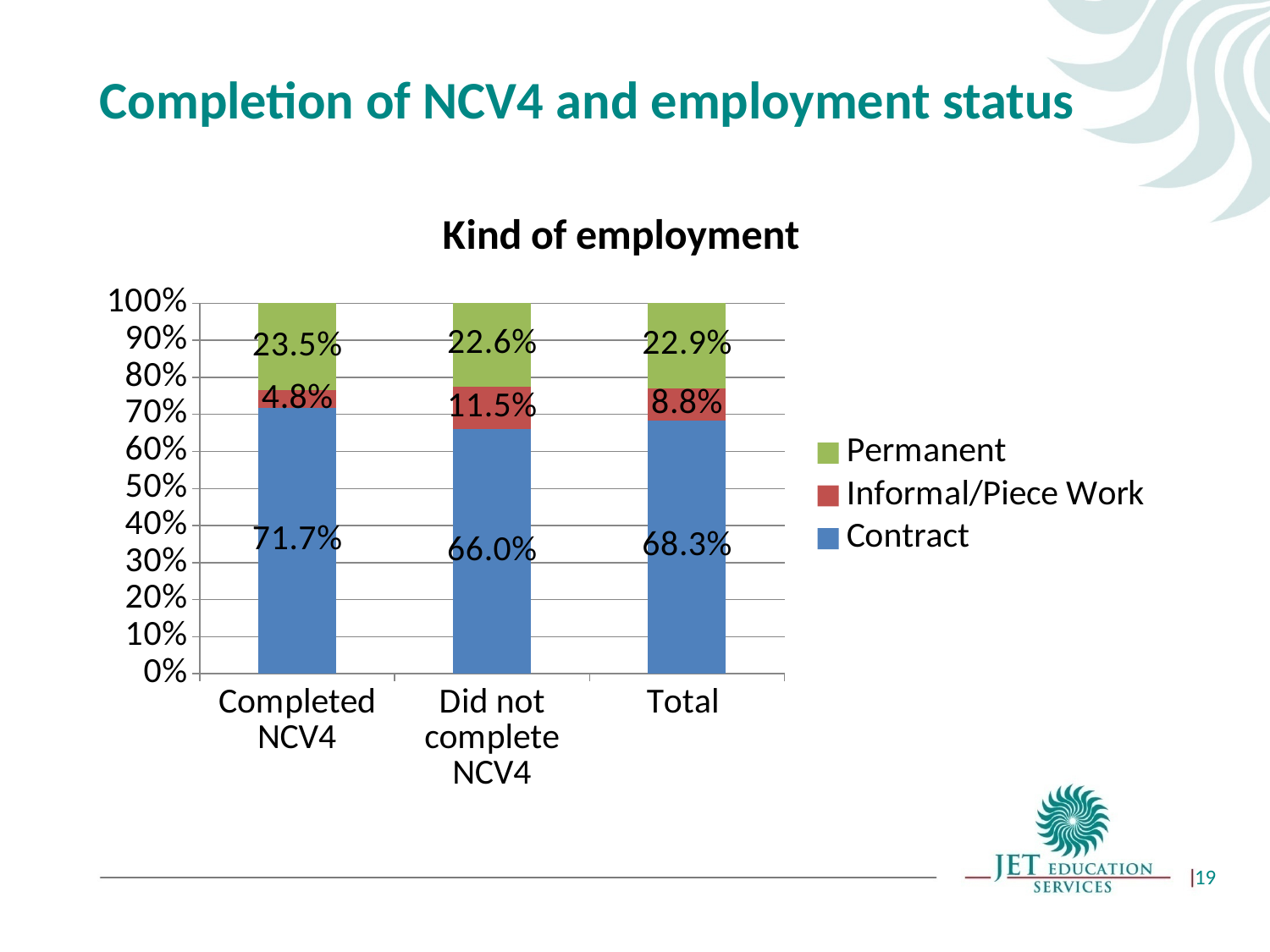
What is the title of the chart? Kind of employment Is the Contract value for Completed NCV4 greater or less than 70%? greater What kind of chart is shown? Stacked bar chart How many series does the legend list? 3 Which category has the lowest Informal/Piece Work value? Completed NCV4 What is the Permanent value for Total? 22.9% What is the difference between the Informal/Piece Work values for Did not complete NCV4 and Completed NCV4? 6.7% Which is larger, the Contract value for Did not complete NCV4 or for Total? Total What is the Informal/Piece Work value for Did not complete NCV4? 11.5% How many categories are shown on the x axis? 3 What is the Contract value for Completed NCV4? 71.7% Which category has the highest Contract value? Completed NCV4